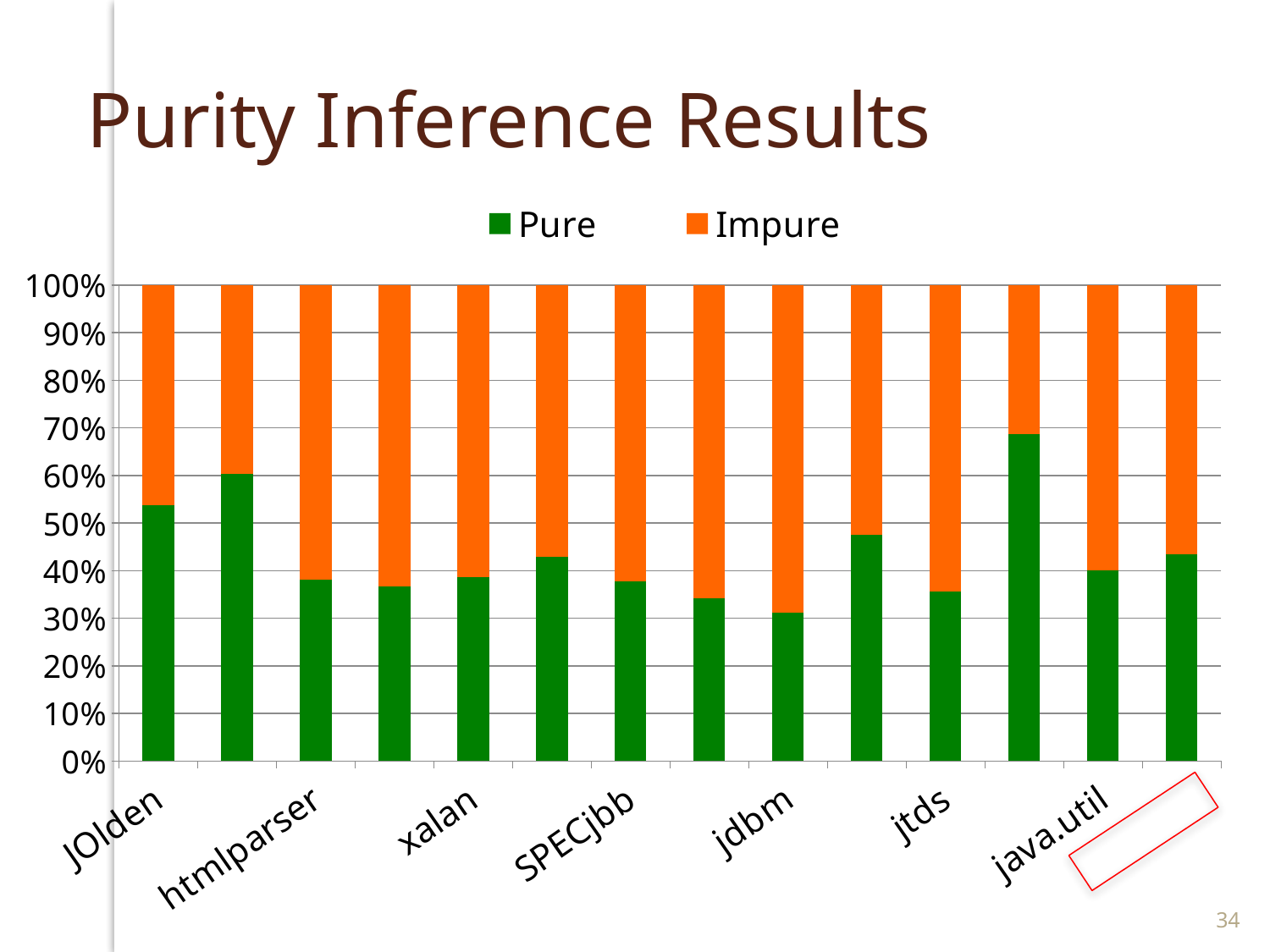
Is the Pure value for jtds greater or less than 40%? less How many series does the legend list? 2 What kind of chart is shown on the slide? Stacked bar chart Is the Pure value for jdbm greater or less than 40%? less Is the Impure value for xalan greater or less than 50%? greater What are the two series named in the legend? Pure and Impure Which colour represents the Pure series? Green How many bars are plotted in the chart? 14 Which has the larger Pure share, JOlden or jdbm? JOlden What is the total of the stacked bar for JOlden? 100%